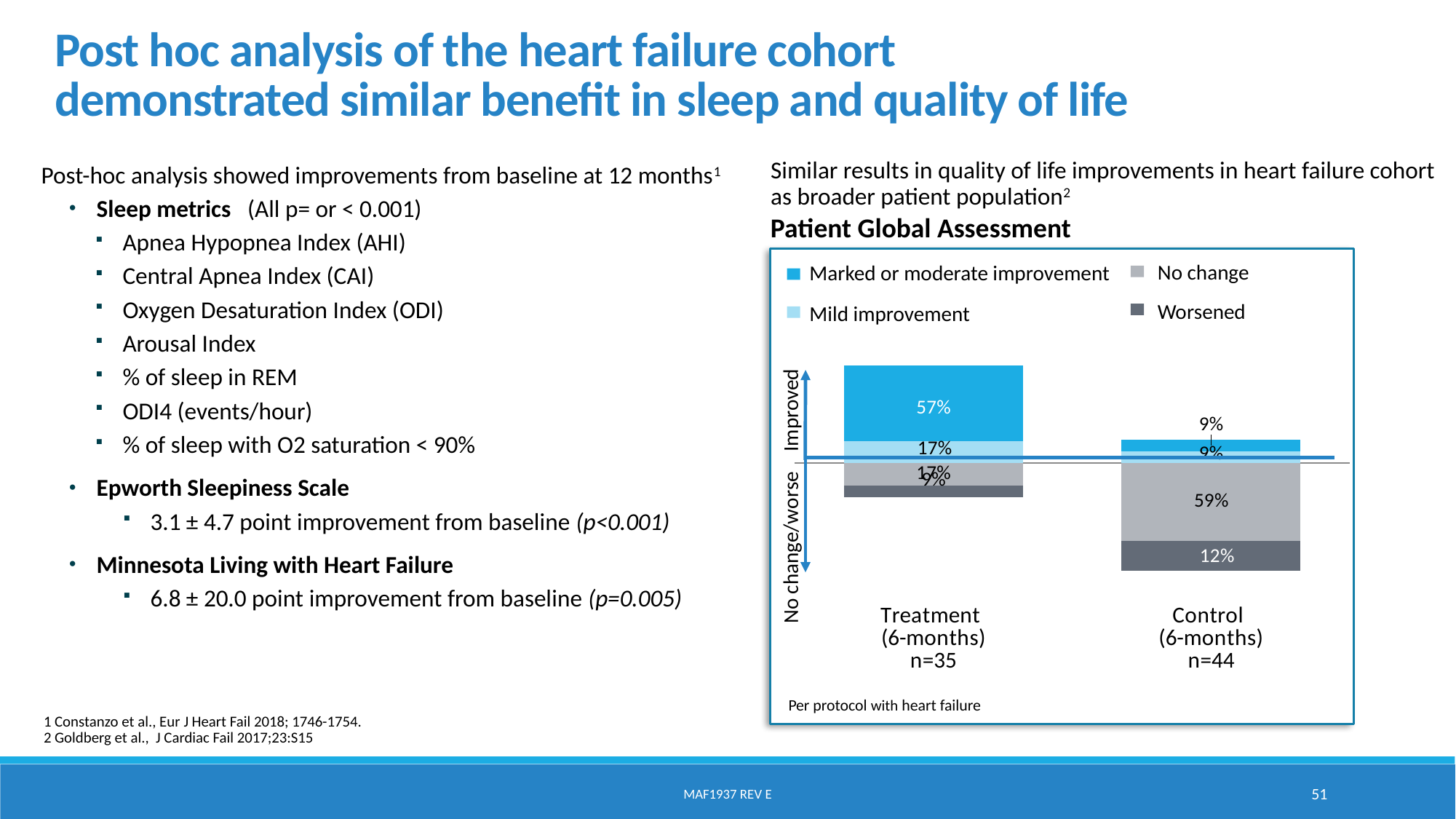
In the Patient Global Assessment chart, which group has the larger share of no change, Treatment or Control? Control In the Patient Global Assessment chart, what percentage of the Treatment (6-months) group had marked or moderate improvement? 57% How many series does the legend of the Patient Global Assessment chart list? 4 In the Patient Global Assessment chart, how many percentage points higher is marked or moderate improvement in the Treatment group than in the Control group? 48 percentage points In the Patient Global Assessment chart, what percentage of the Treatment (6-months) group had mild improvement? 17% In the Patient Global Assessment chart, which group has the larger share of marked or moderate improvement, Treatment or Control? Treatment In the Patient Global Assessment chart, what is the difference between the no change and worsened shares in the Control group? 47 percentage points In the Patient Global Assessment chart, what percentage of the Control (6-months) group had marked or moderate improvement? 9% How many groups (bars) are shown in the Patient Global Assessment chart? 2 What kind of chart is the Patient Global Assessment chart? Stacked bar chart In the Patient Global Assessment chart, what percentage of the Control (6-months) group had no change? 59% In the Patient Global Assessment chart, what percentage of the Control (6-months) group worsened? 12%